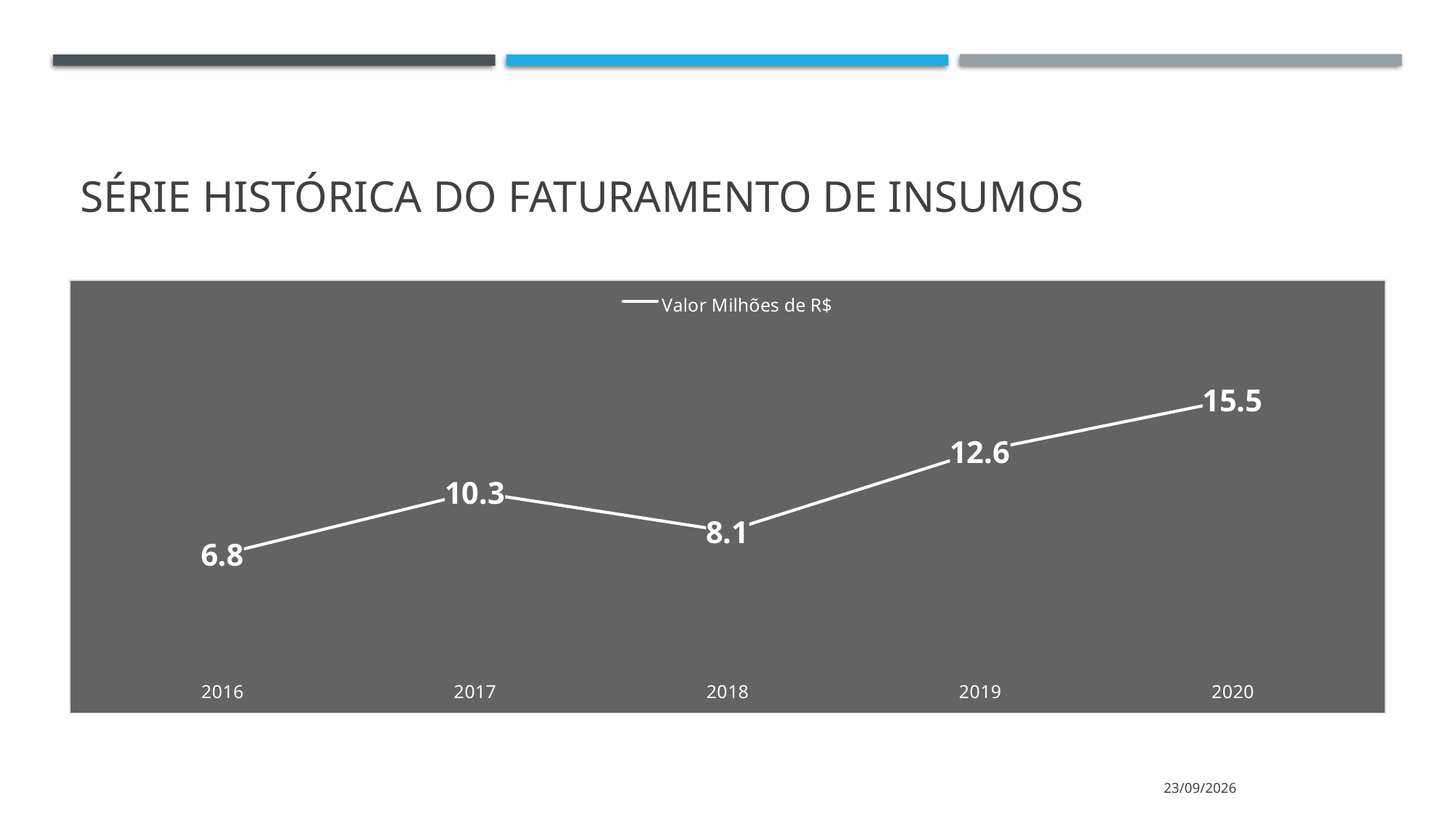
Which year has the highest value? 2020 What is the value for 2018? 8.1 What is the name of the series shown in the legend? Valor Milhões de R$ Which is larger, the value for 2017 or the value for 2018? 2017 What is the value for 2020? 15.5 What is the value for 2016? 6.8 Which year has the lowest value? 2016 How many years are plotted on the chart? 5 How many series does the legend list? 1 What is the difference between the values for 2017 and 2018? 2.2 What is the difference between the values for 2020 and 2019? 2.9 What kind of chart is shown on the slide? line chart